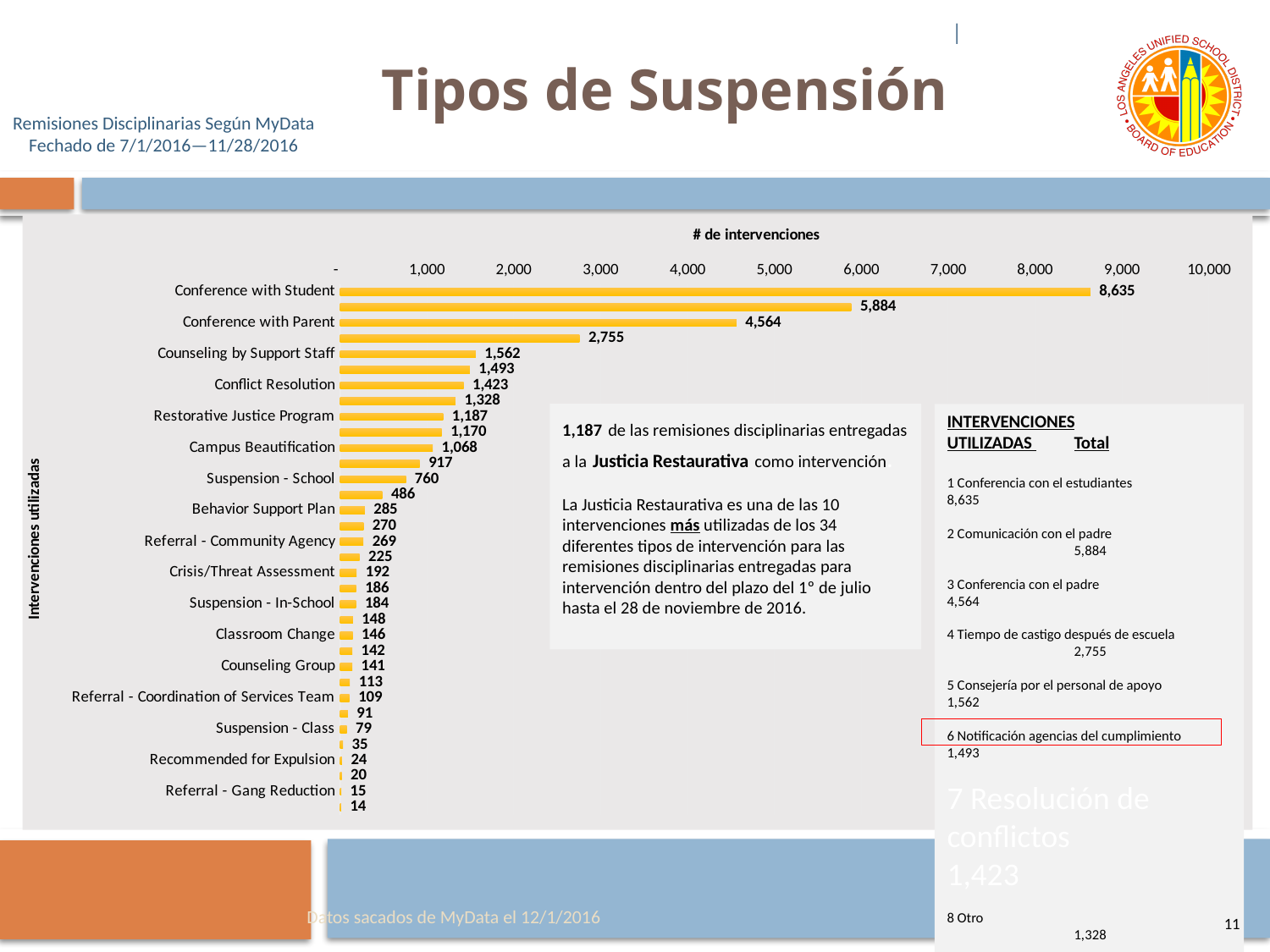
What type of chart is shown on the slide? bar chart Which is larger, Counseling by Support Staff or Campus Beautification? Counseling by Support Staff What is the title of the horizontal axis? # de intervenciones What is the value for Suspension - School? 760 Is the value for Conference with Parent greater or less than 4,000? greater Which labeled category has the highest value? Conference with Student Which labeled category has the lowest value? Referral - Gang Reduction What is the value for Restorative Justice Program? 1,187 What is the value for Conference with Student? 8,635 What is the difference between Conference with Student and Conference with Parent? 4,071 What is the value for Conflict Resolution? 1,423 What is the title of the vertical axis? Intervenciones utilizadas